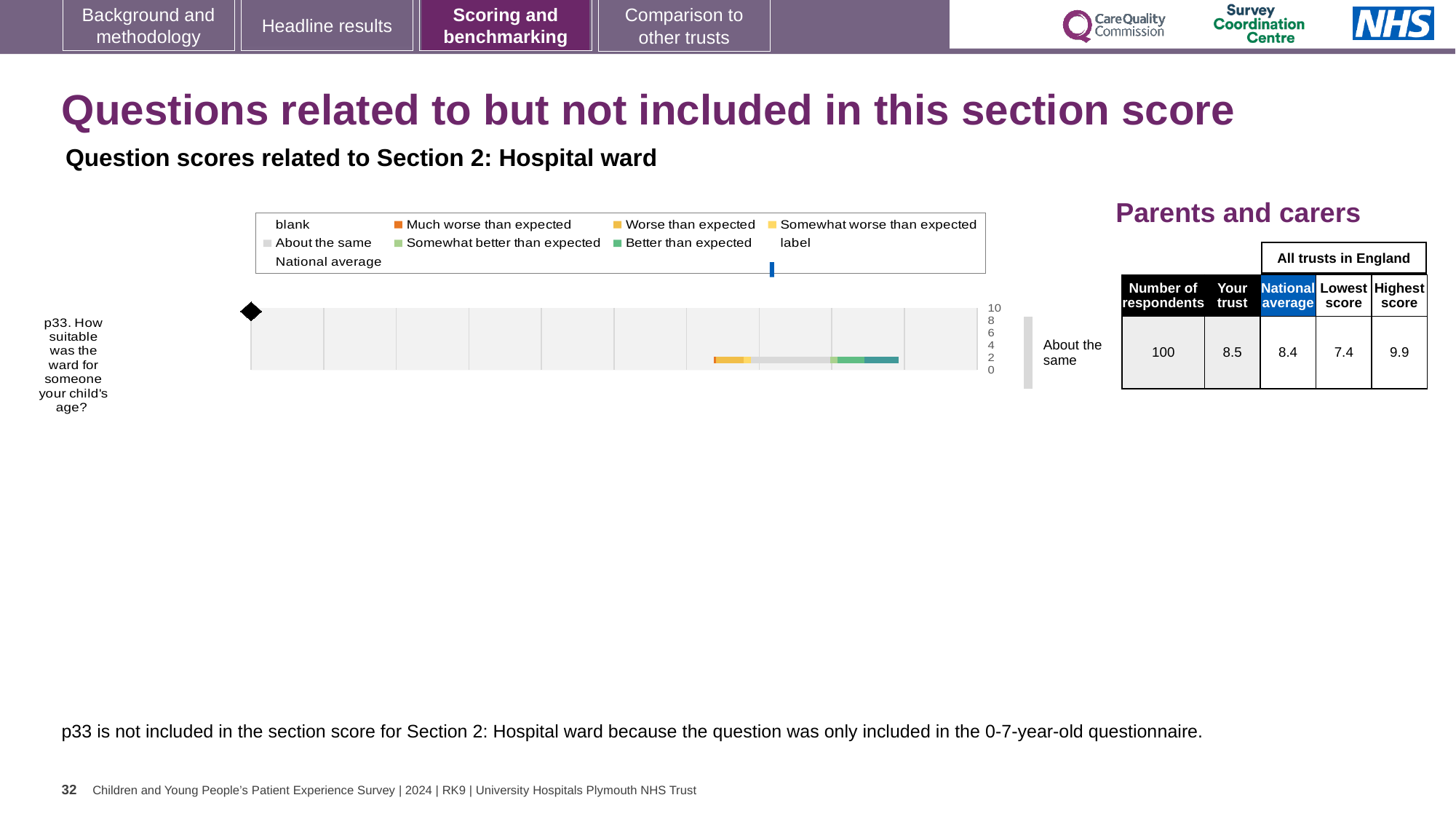
What benchmark label is shown to the right of the bar for p33? About the same How many questions (categories) are plotted in the chart? 1 In the table next to the chart, what is the highest score among all trusts in England for p33? 9.9 For p33, which is larger: the 'Your trust' score or the national average? Your trust In the table next to the chart, how many respondents answered p33? 100 In the table next to the chart, what is the 'Your trust' score for p33? 8.5 In the table next to the chart, what is the national average score for p33? 8.4 For p33, what is the difference between the highest score and the lowest score among all trusts in England? 2.5 In the table next to the chart, what is the lowest score among all trusts in England for p33? 7.4 Which question is plotted in the chart? p33. How suitable was the ward for someone your child's age? What kind of chart is shown on the slide? bar chart How many entries does the chart's legend list? 9